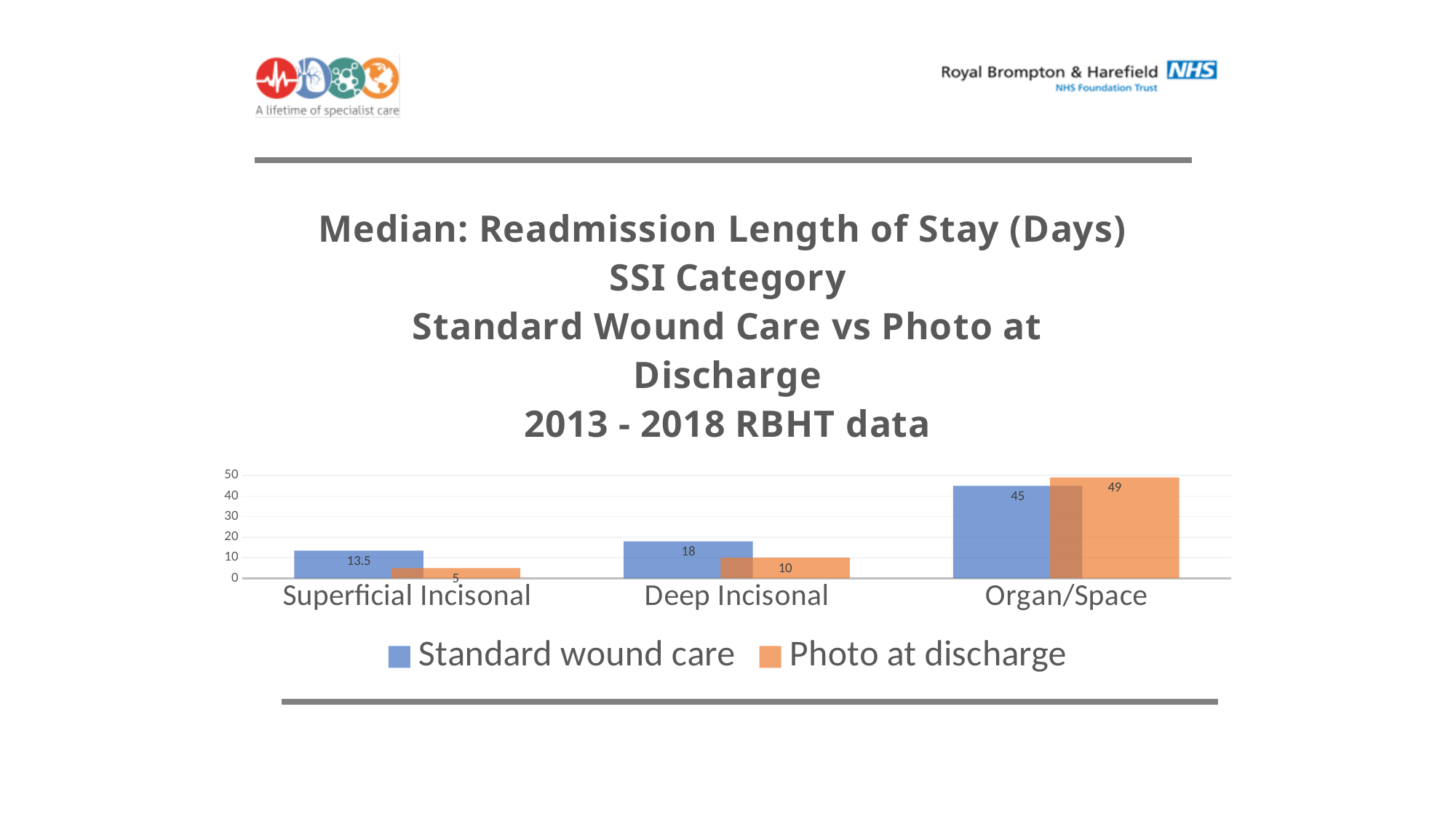
How many series does the legend list? 2 What is the value for Photo at discharge in the Organ/Space category? 49 How many SSI categories are shown on the x axis? 3 Which SSI category has the highest value for Standard wound care? Organ/Space What is the difference between Photo at discharge and Standard wound care in the Organ/Space category? 4 What is the median readmission length of stay for Standard wound care in the Superficial Incisonal category? 13.5 What is the difference between Standard wound care and Photo at discharge in the Superficial Incisonal category? 8.5 What is the median readmission length of stay for Photo at discharge in the Deep Incisonal category? 10 In the Deep Incisonal category, which is larger: Standard wound care or Photo at discharge? Standard wound care What kind of chart is shown on the slide? Bar chart What is the value for Standard wound care in the Deep Incisonal category? 18 Which SSI category has the lowest value for Photo at discharge? Superficial Incisonal